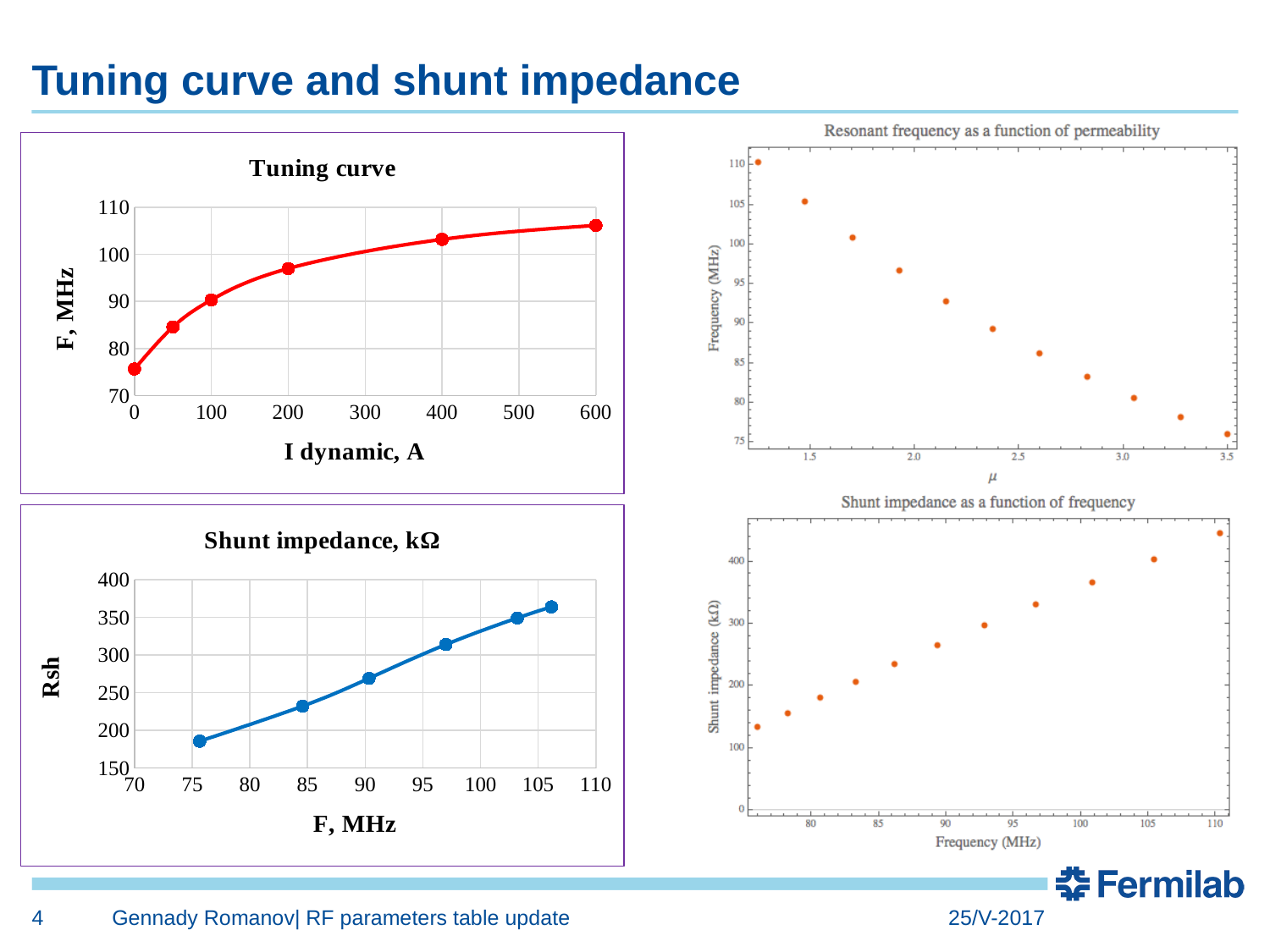
In the Tuning curve chart, do the values rise or fall as I dynamic increases? rise In the chart titled Resonant frequency as a function of permeability, do the values rise or fall as μ increases? fall In the chart titled Shunt impedance as a function of frequency, is the value at the highest frequency greater or less than 400? greater In the Shunt impedance, kΩ chart, is the highest plotted value greater or less than 350? greater In the Tuning curve chart, is the value at I dynamic = 600 A greater or less than 100 MHz? greater What kind of chart is the Tuning curve chart? line chart In the Tuning curve chart, how many data points are plotted? 6 In the Shunt impedance, kΩ chart, how many data points are plotted? 6 In the Shunt impedance, kΩ chart, do the values rise or fall as F increases? rise